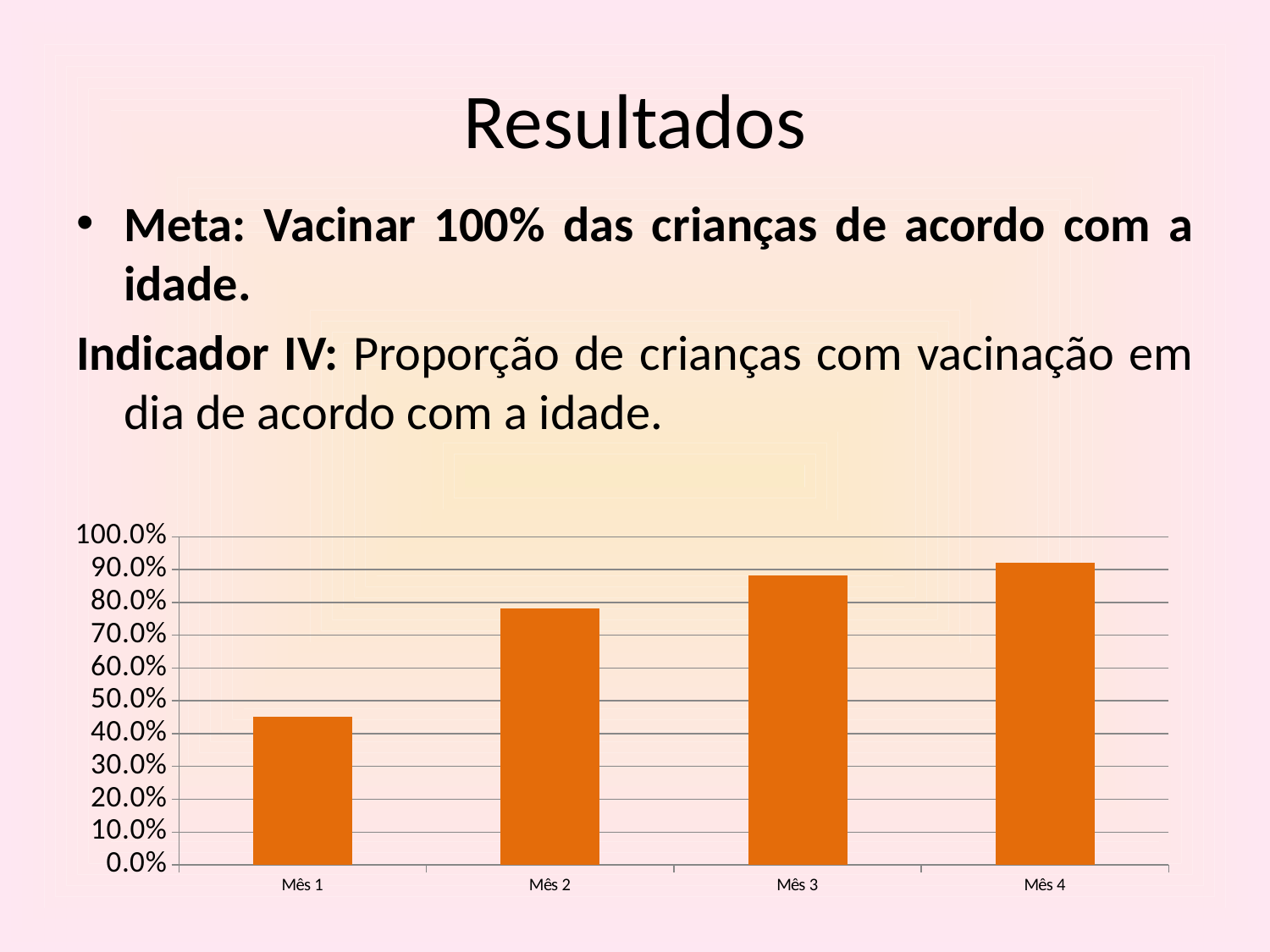
Do the values rise or fall from Mês 1 to Mês 4? rise Is the value for Mês 1 greater or less than 50.0%? less What kind of chart is shown on the slide? bar chart Which is larger, the value for Mês 2 or the value for Mês 3? Mês 3 Which month has the highest bar on the chart? Mês 4 Is the value for Mês 4 greater or less than 100.0%? less Is the value for Mês 1 greater or less than 40.0%? greater How many categories (months) are plotted on the chart? 4 What colour are the bars on the chart? orange Which month has the lowest bar on the chart? Mês 1